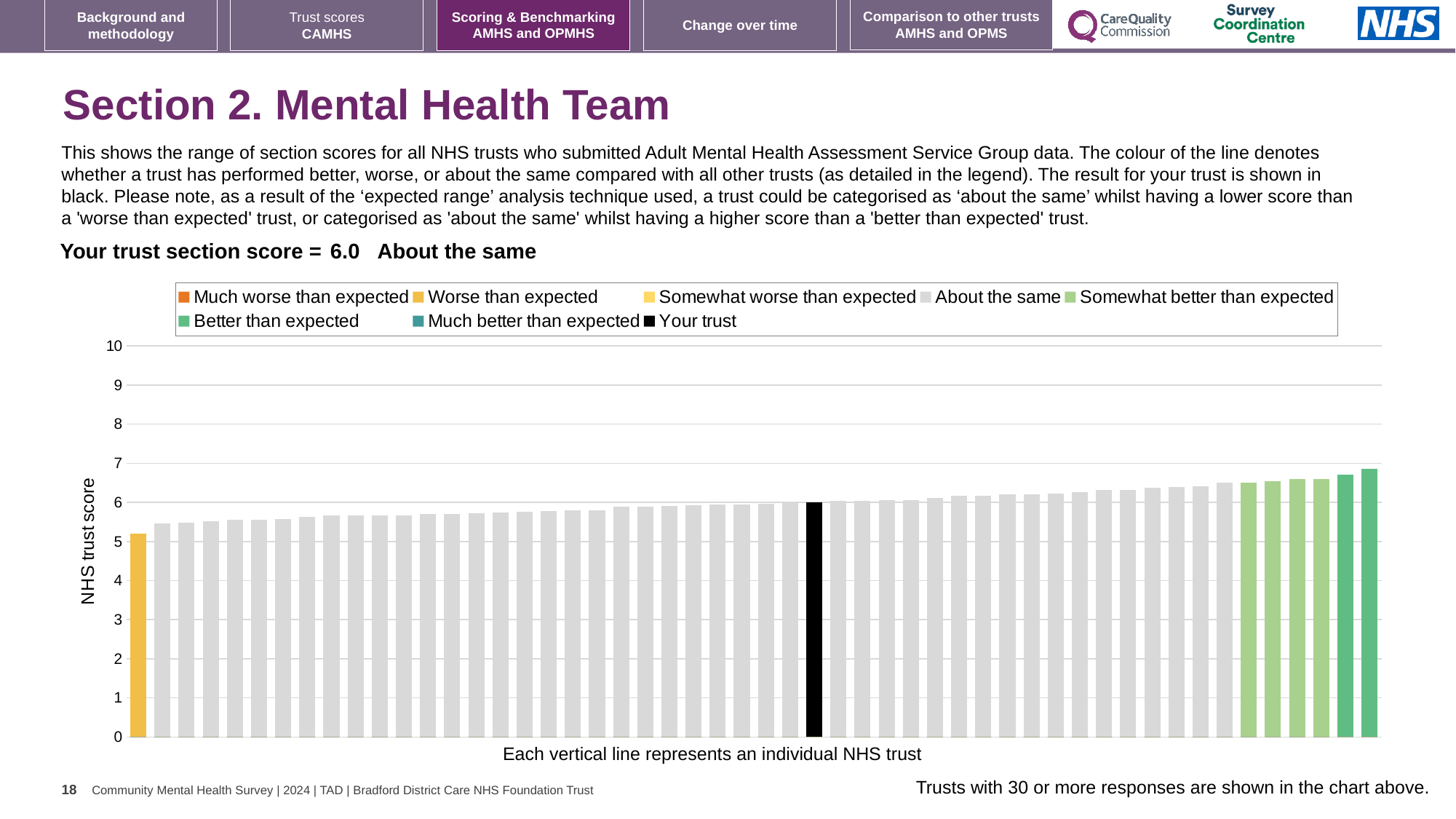
Is the value of the rightmost bar greater or less than 6? greater What is the highest value shown on the vertical axis? 10 What is the section score for your trust shown on the slide? 6.0 What is the label on the vertical axis of the chart? NHS trust score How many entries does the chart legend list? 8 Do the bar values rise or fall from left to right across the chart? rise How many bars in the chart are coloured black? 1 Is the value of the black 'Your trust' bar greater or less than 5? greater Is the value of the black 'Your trust' bar greater or less than 7? less Which category is your trust placed in for this section? About the same What kind of chart is shown on the slide? bar chart